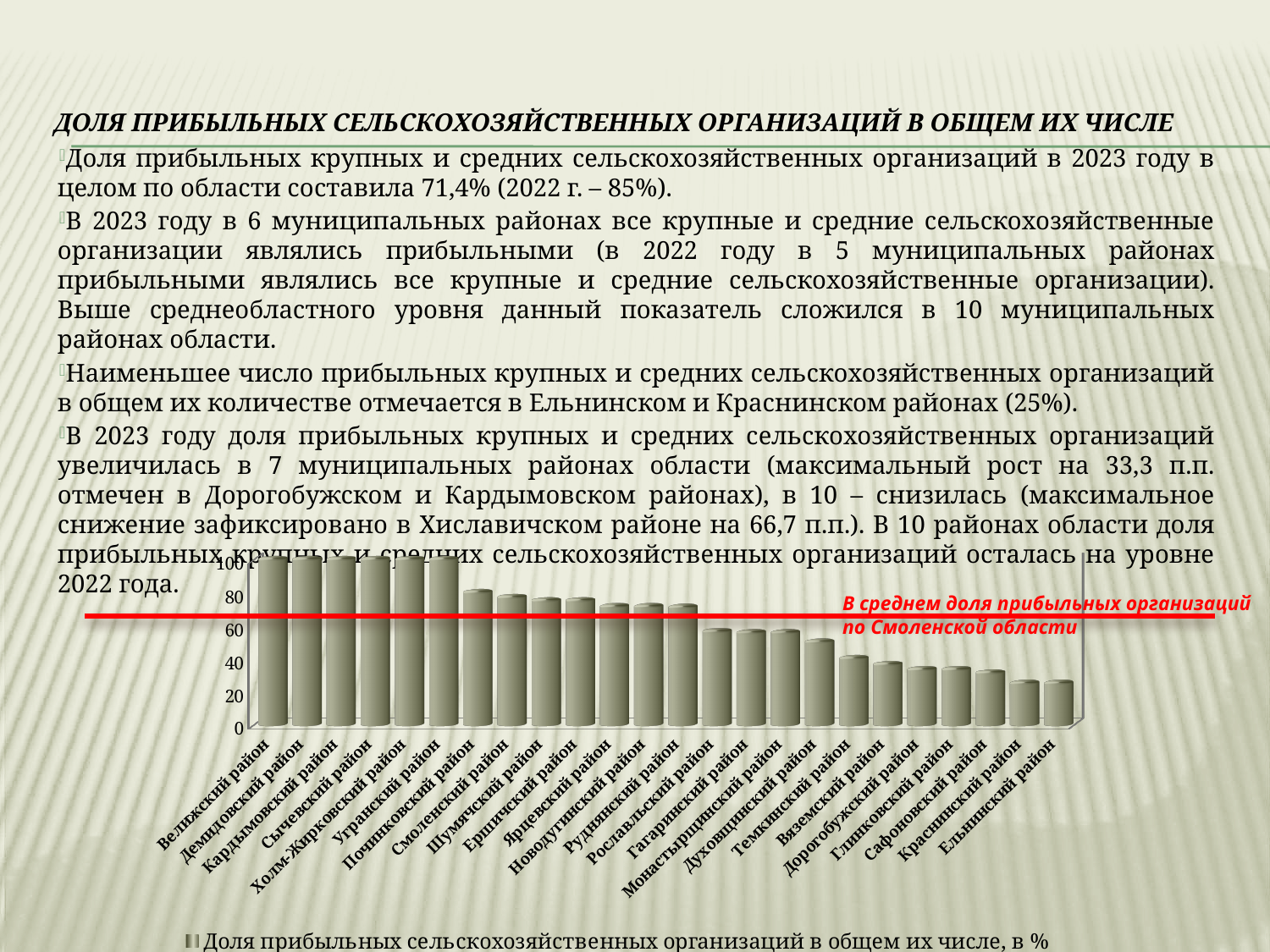
Is the value for Темкинский район greater or less than 60? less Is the value for Ярцевский район greater or less than 60? greater What does the red horizontal line on the chart represent? В среднем доля прибыльных организаций по Смоленской области What does the legend entry of the chart say? Доля прибыльных сельскохозяйственных организаций в общем их числе, в % What is the value for Велижский район? 100 Do the values rise or fall moving from left to right along the x axis? fall How many series does the chart legend list? 1 How many districts (categories) are plotted on the chart? 24 Is the value for Рославльский район greater or less than 80? less What kind of chart is shown on the slide? bar chart Which has the larger value, Починковский район or Темкинский район? Починковский район